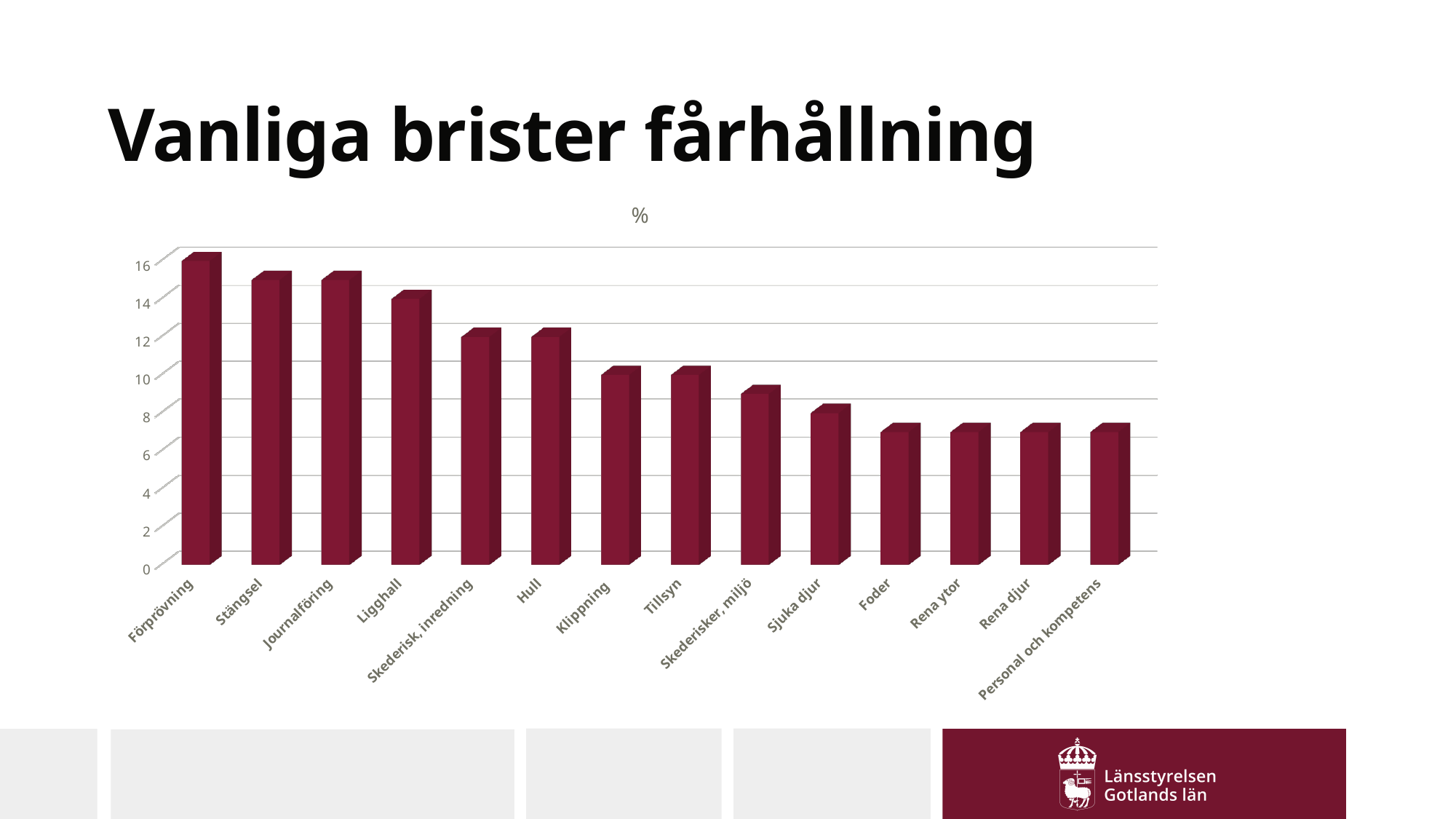
Is the value for Skederisker, miljö greater or less than 8? greater What is the value for Klippning? 10 Which category has the highest value in the chart? Förprövning What is the value for Förprövning? 16 Is the value for Foder greater or less than 8? less Do the values generally rise or fall from left to right along the x axis? fall Which is larger, the value for Hull or the value for Tillsyn? Hull What is the value for Ligghall? 14 Is the value for Stängsel greater or less than 14? greater What is the title shown above the chart? % What kind of chart is shown on the slide? bar chart How many categories are shown on the x axis of the chart? 14